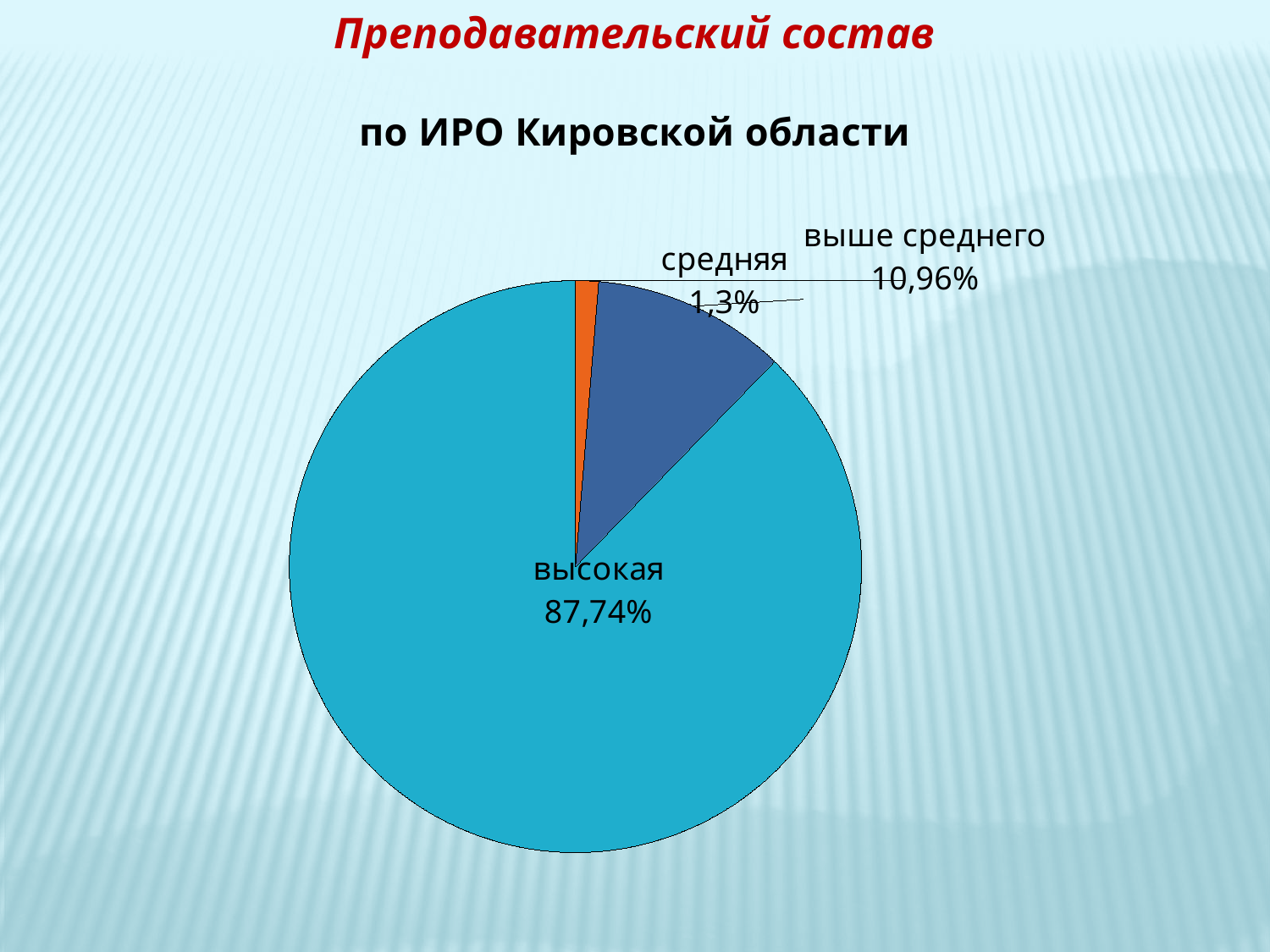
Which is larger, the "выше среднего" slice or the "средняя" slice? выше среднего What is the difference between the "выше среднего" and "средняя" shares? 9,66% What is the title of the slide containing the chart? Преподавательский состав How many slices does the pie chart have? 3 What share of the pie does the "высокая" slice represent? 87,74% Which category has the smallest slice of the pie? средняя What is the difference between the "высокая" and "выше среднего" shares? 76,78% What colour is the "средняя" slice? orange What value is shown for the "средняя" slice? 1,3% Which category has the largest slice of the pie? высокая What kind of chart is shown on the slide? pie chart What value is shown for the "выше среднего" slice? 10,96%